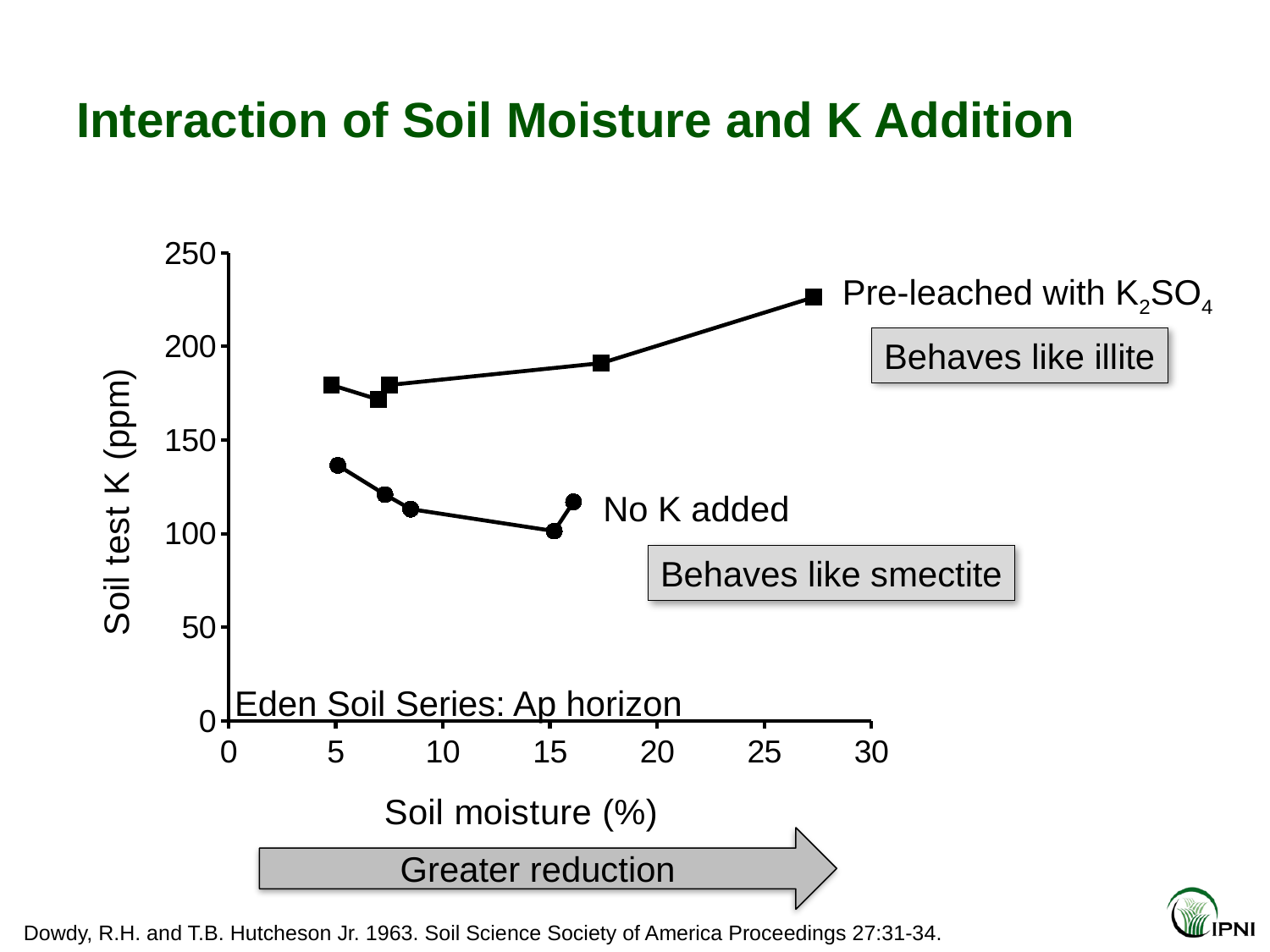
Is the soil test K value for the 'Pre-leached with K2SO4' point at the highest soil moisture greater or less than 200? greater How many data points are plotted for the 'Pre-leached with K2SO4' series? 5 Which series has higher soil test K values, 'Pre-leached with K2SO4' or 'No K added'? Pre-leached with K2SO4 Is the soil test K value for the 'No K added' point at about 15% soil moisture greater or less than 150? less What is the label of the y axis? Soil test K (ppm) Is the soil test K value for the 'No K added' point at about 5% soil moisture greater or less than 150? less How many data series are plotted on the chart? 2 Does soil test K for the 'No K added' series generally rise or fall as soil moisture increases from 5% to 15%? fall How many data points are plotted for the 'No K added' series? 5 Does soil test K for the 'Pre-leached with K2SO4' series rise or fall as soil moisture increases? rise What is the title of the slide's chart? Interaction of Soil Moisture and K Addition What kind of chart is shown on the slide? line chart